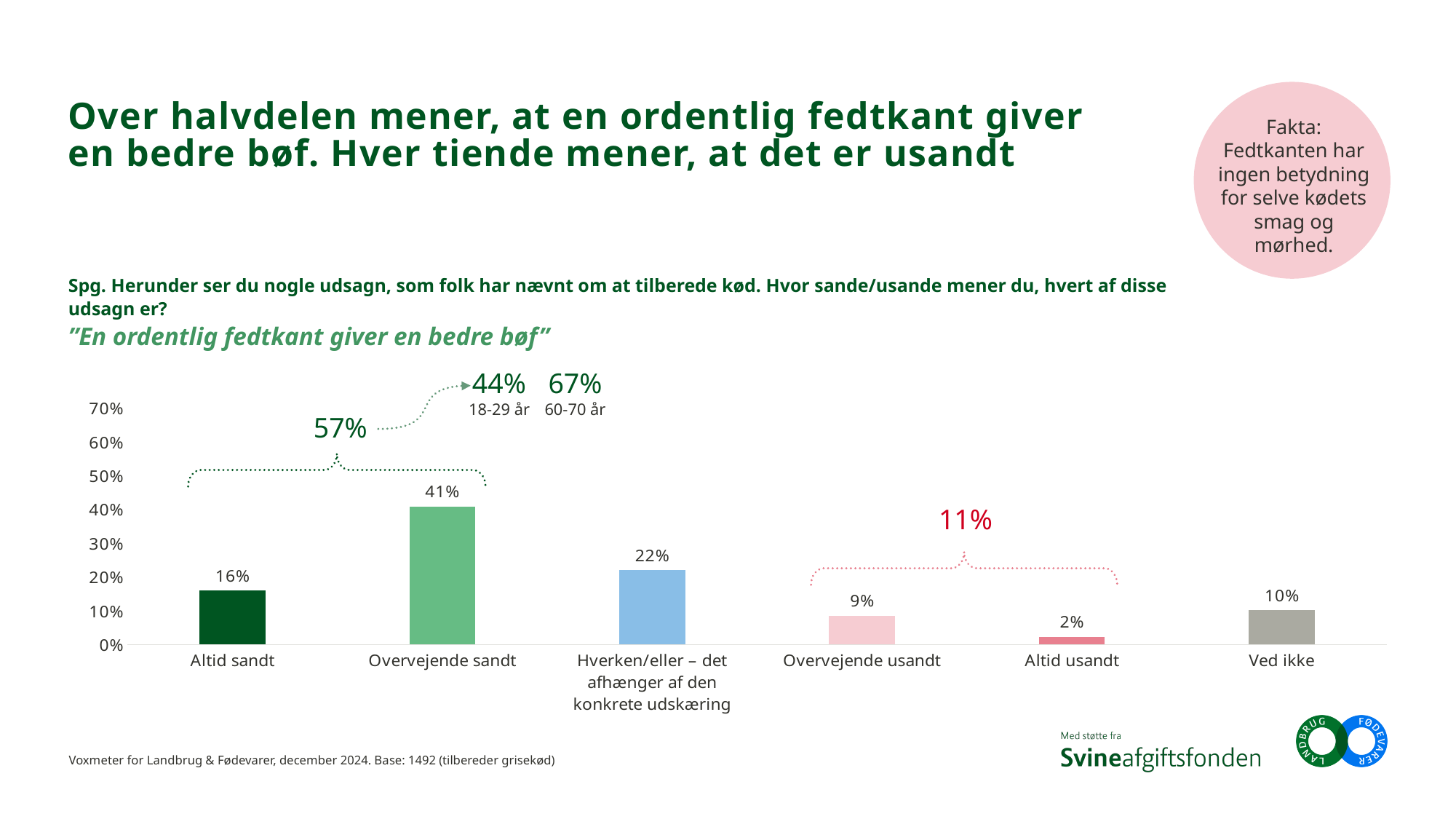
What is the value for "Overvejende sandt"? 41% Which is larger, the value for "Hverken/eller – det afhænger af den konkrete udskæring" or the value for "Altid sandt"? Hverken/eller – det afhænger af den konkrete udskæring Which category has the highest value? Overvejende sandt What kind of chart is shown on the slide? bar chart What is the value for "Altid usandt"? 2% What is the value for "Ved ikke"? 10% What is the difference between the values for "Overvejende sandt" and "Altid sandt"? 25% How many categories are shown on the x axis? 6 Is the value for "Overvejende usandt" greater or less than 10%? less What percentage is shown for the 60-70 år age group in the annotation above the chart? 67% Which category has the lowest value? Altid usandt What combined percentage is shown above the bracket spanning "Altid sandt" and "Overvejende sandt"? 57%